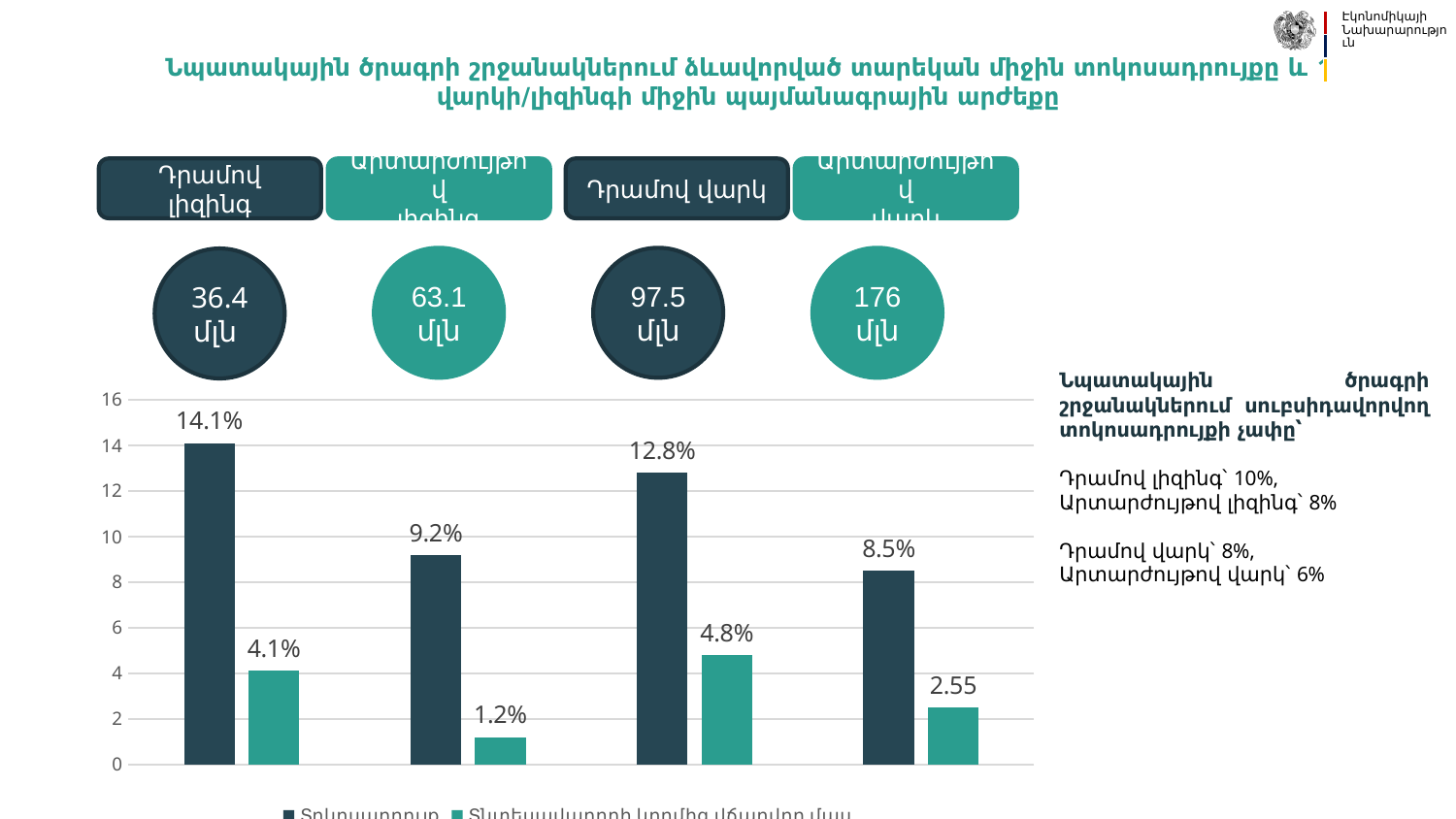
Which group has the lowest light green bar? Արտարժույթով լիզինգ (second group) How many series does the chart's legend list? 2 What is the value of the light green bar in the fourth group (Արտարժույթով վարկ)? 2.55 What is the value of the dark bar in the third group (Դրամով վարկ)? 12.8% Is the dark bar in the fourth group (Արտարժույթով վարկ) greater or less than 10? less Which group has the highest dark bar? Դրամով լիզինգ (first group) What is the difference between the dark bar and the light green bar in the first group (Դրամով լիզինգ)? 10 percentage points Which is larger: the light green bar in the first group (4.1%) or the light green bar in the third group (4.8%)? the third group (4.8%) What is the value of the dark bar in the first group (Դրամով լիզինգ)? 14.1% What kind of chart is shown on the slide? bar chart What is the value of the light green bar in the second group (Արտարժույթով լիզինգ)? 1.2% How many groups of bars does the chart have? 4